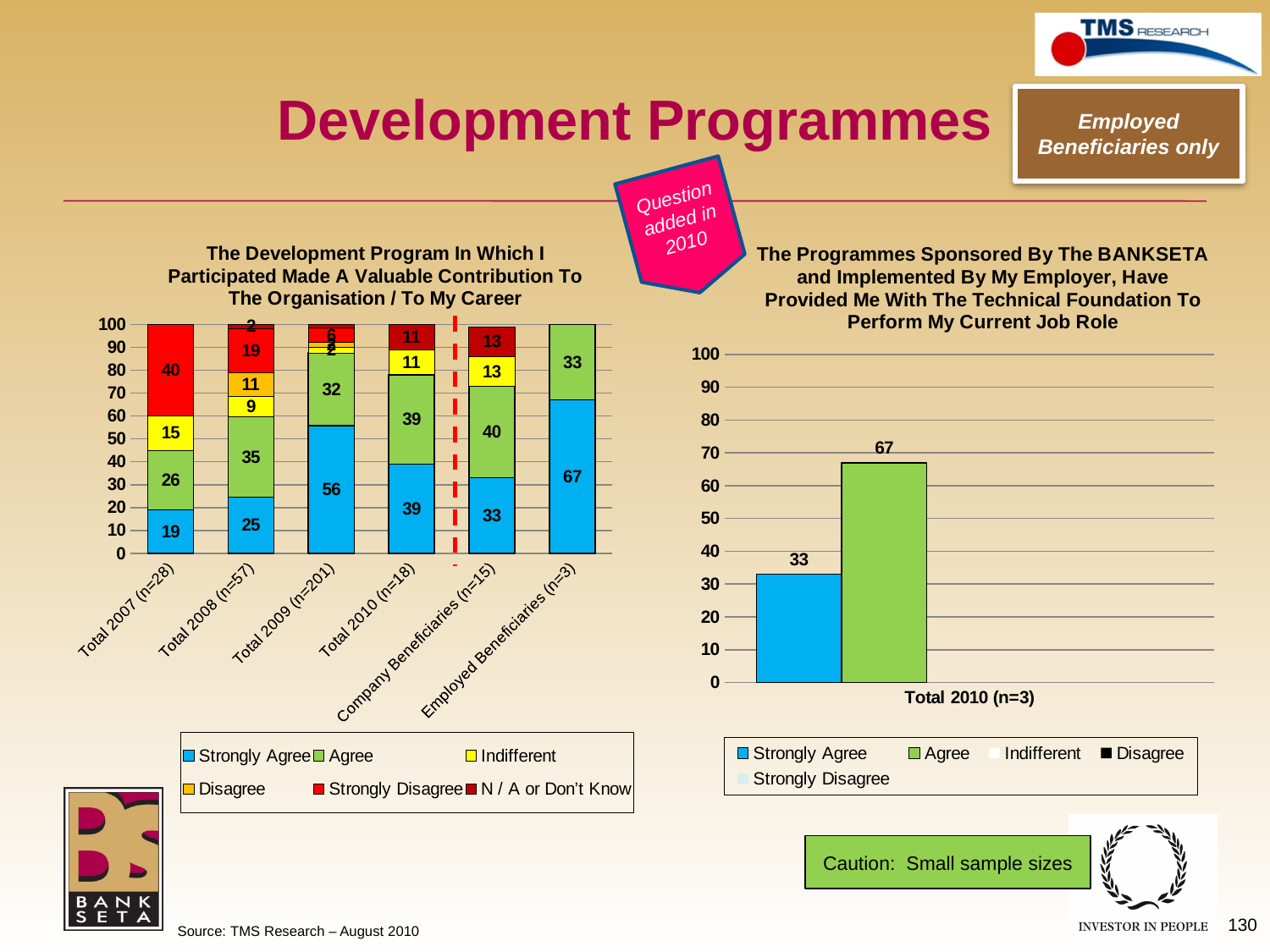
What kind of chart is the right chart (The Programmes Sponsored By The BANKSETA...)? Bar chart In the right chart (The Programmes Sponsored By The BANKSETA...), how many series does the legend list? 5 In the left chart (The Development Program In Which I Participated...), what is the Strongly Disagree value for Total 2007 (n=28)? 40 In the left chart (The Development Program In Which I Participated...), which category has the highest Strongly Agree value? Employed Beneficiaries (n=3) In the right chart (The Programmes Sponsored By The BANKSETA...), what is the value for Agree for Total 2010 (n=3)? 67 In the left chart (The Development Program In Which I Participated...), is the Strongly Agree value for Total 2008 (n=57) larger or smaller than that for Total 2009 (n=201)? Smaller In the left chart (The Development Program In Which I Participated...), how many series does the legend list? 6 In the left chart (The Development Program In Which I Participated...), how many categories are shown on the x axis? 6 In the left chart (The Development Program In Which I Participated...), what is the Strongly Agree value for Total 2007 (n=28)? 19 In the right chart (The Programmes Sponsored By The BANKSETA...), what is the value for Strongly Agree for Total 2010 (n=3)? 33 In the right chart (The Programmes Sponsored By The BANKSETA...), what is the difference between the Agree and Strongly Agree values? 34 In the left chart (The Development Program In Which I Participated...), what is the Agree value for Company Beneficiaries (n=15)? 40